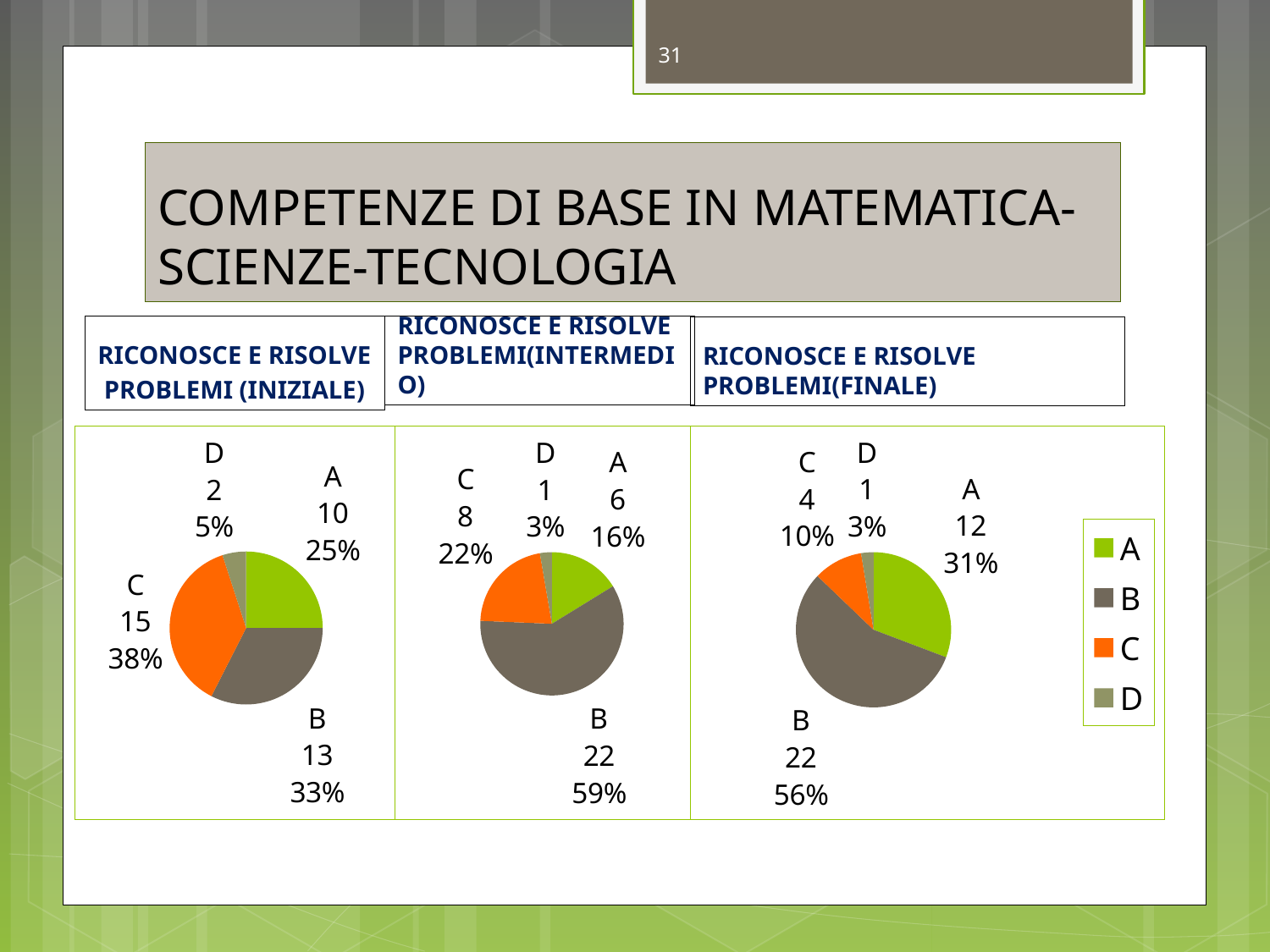
In the left pie chart (INIZIALE), what percentage share does category A have? 25% What type of chart is used on this slide? Pie chart In the left pie chart (INIZIALE), what is the value for category C? 15 In the middle pie chart (INTERMEDIO), what is the value for category B? 22 In the left pie chart (INIZIALE), which category has the smallest value? D In the middle pie chart (INTERMEDIO), what percentage share does category C have? 22% In the left pie chart (INIZIALE), which category has the largest value? C How many categories does the legend list? 4 In the right pie chart (FINALE), which is larger, the value for A or the value for C? A In the right pie chart (FINALE), what is the value for category A? 12 In the right pie chart (FINALE), what percentage share does category B have? 56% In the middle pie chart (INTERMEDIO), what is the difference between the values for B and A? 16